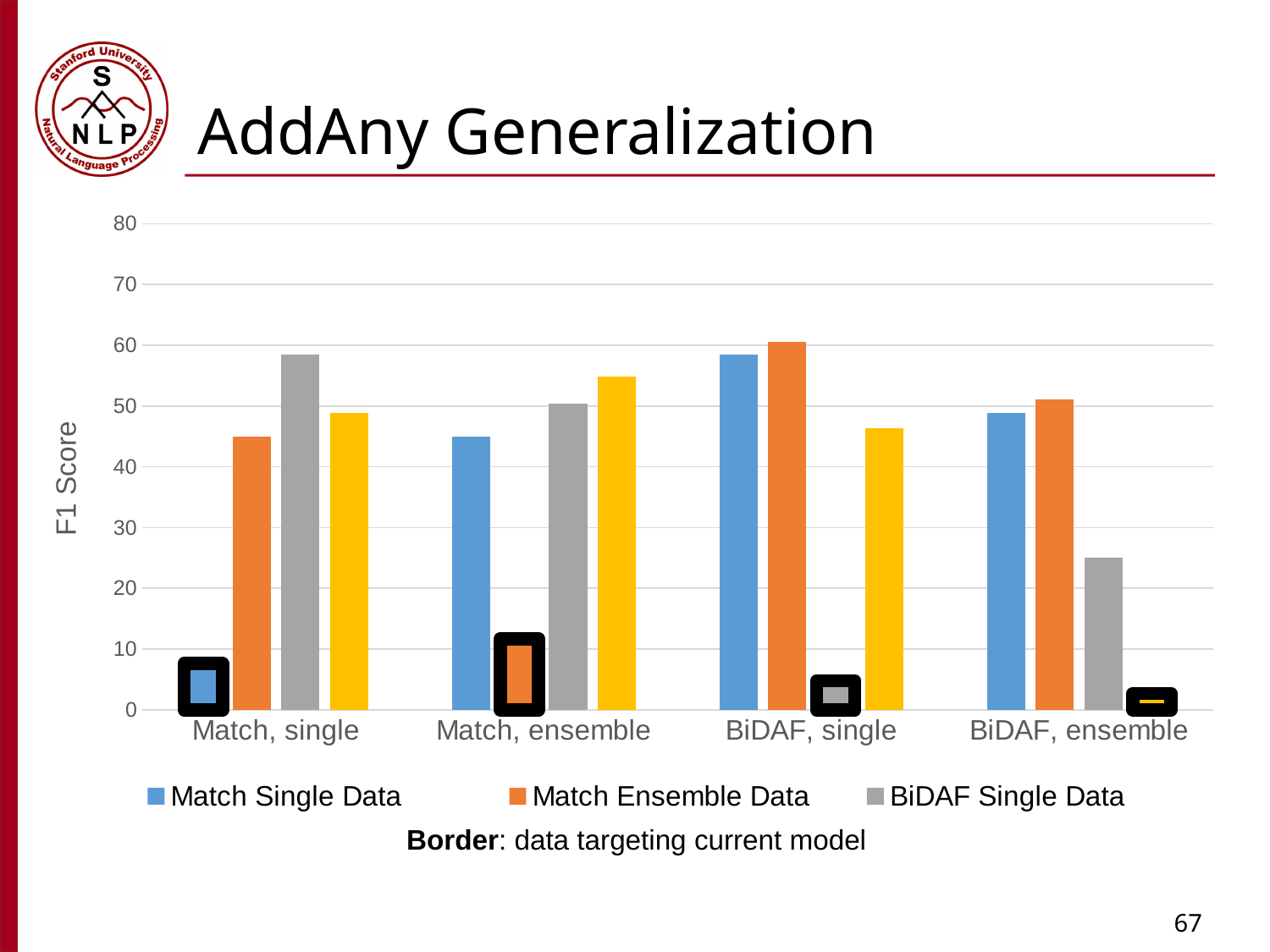
Is the Match Single Data value for Match, single greater or less than 10? less For BiDAF, single, which is larger: Match Single Data or BiDAF Single Data? Match Single Data Which category has the lowest BiDAF Single Data bar? BiDAF, single What kind of chart is shown on the slide? bar chart How many series does the chart's legend list? 3 How many categories are shown on the x axis of the chart? 4 Is the BiDAF Single Data value for BiDAF, ensemble greater or less than 30? less For Match, ensemble, which is larger: Match Single Data or Match Ensemble Data? Match Single Data Is the Match Single Data value for Match, ensemble greater or less than 40? greater What is the label on the y axis of the chart? F1 Score Which category has the highest Match Ensemble Data bar? BiDAF, single